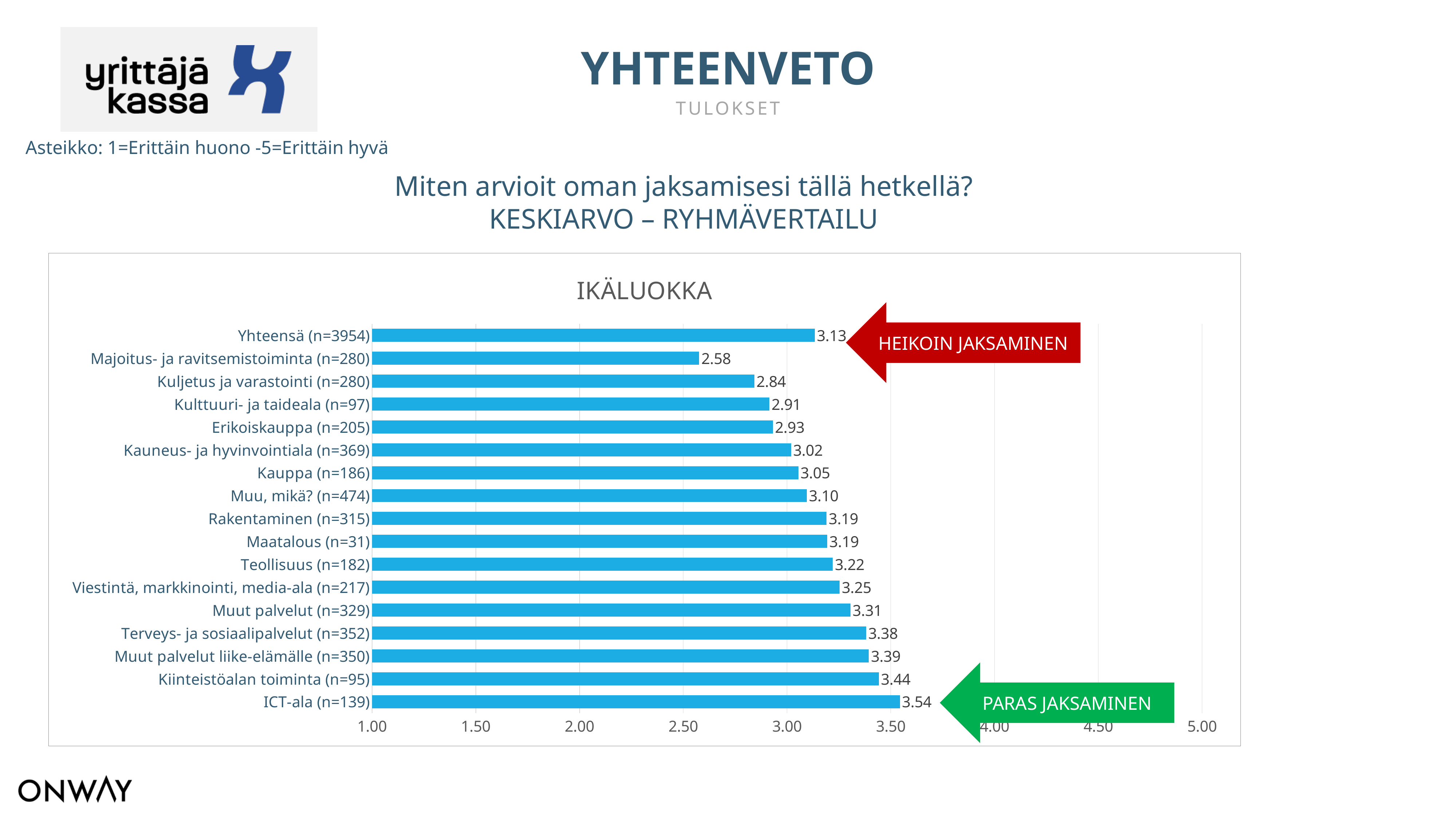
What is the value for Terveys- ja sosiaalipalvelut (n=352)? 3.38 What is the value for Kauneus- ja hyvinvointiala (n=369)? 3.02 What is the value for Yhteensä (n=3954)? 3.13 Which is larger, the value for Kuljetus ja varastointi (n=280) or the value for Kiinteistöalan toiminta (n=95)? Kiinteistöalan toiminta (n=95) Is the value for Muut palvelut (n=329) greater or less than 3.00? greater What is the value for Majoitus- ja ravitsemistoiminta (n=280)? 2.58 How many categories are shown in the chart? 17 What is the chart's title? IKÄLUOKKA Which category has the lowest value? Majoitus- ja ravitsemistoiminta (n=280) What is the difference between the values for ICT-ala (n=139) and Majoitus- ja ravitsemistoiminta (n=280)? 0.96 What type of chart is shown on the slide? bar chart Which category has the highest value? ICT-ala (n=139)